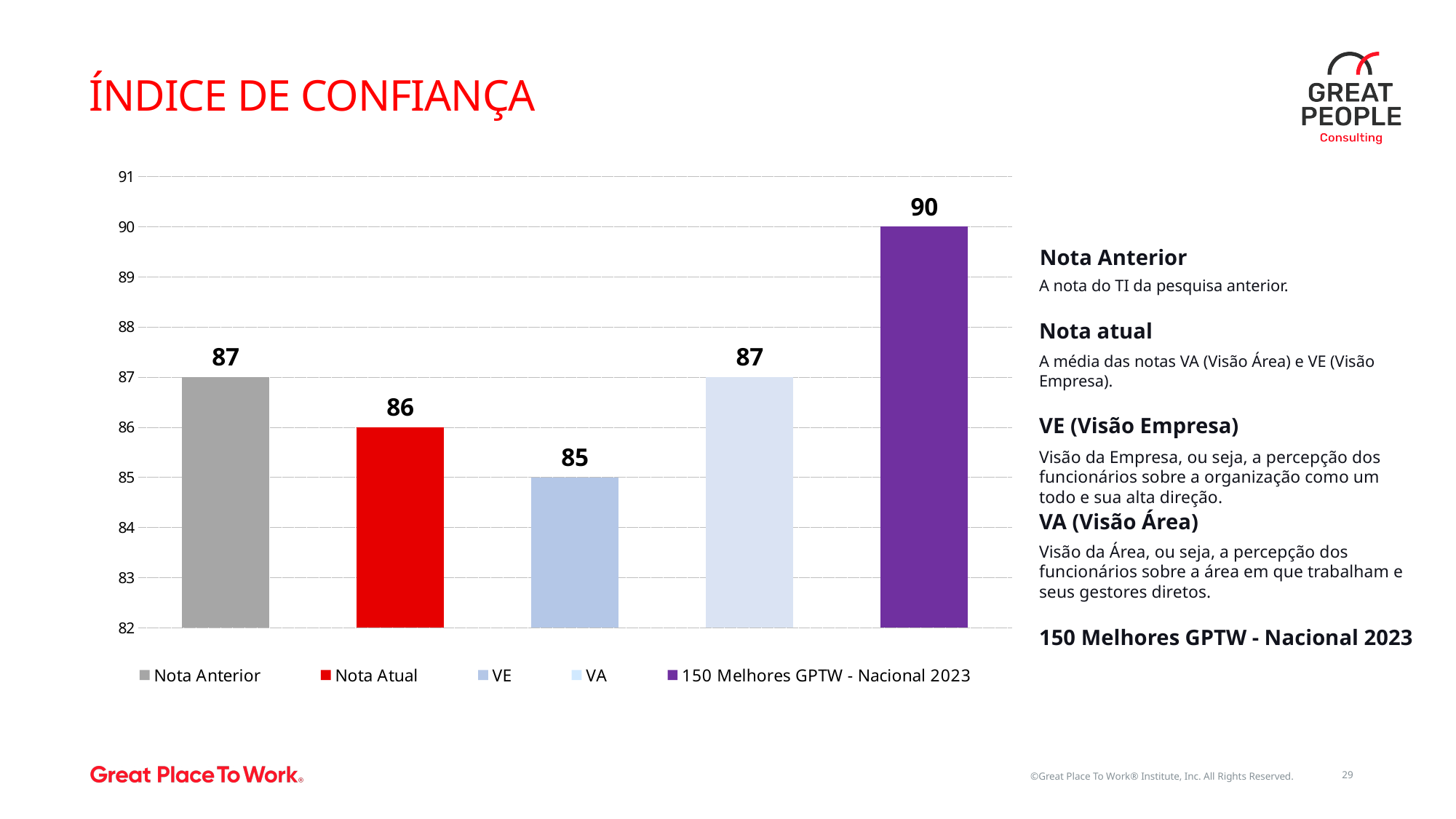
Which series has the lowest value? VE Which series has the highest value? 150 Melhores GPTW - Nacional 2023 Which is larger, Nota Anterior or Nota Atual? Nota Anterior What colour is the Nota Atual bar? Red What is the difference between the 150 Melhores GPTW - Nacional 2023 value and the Nota Atual value? 4 What is the value of the Nota Atual bar? 86 What is the value of the 150 Melhores GPTW - Nacional 2023 bar? 90 What kind of chart is shown on the slide? Bar chart What is the value of the VE bar? 85 What is the difference between the VA value and the VE value? 2 What is the value of the Nota Anterior bar? 87 How many series does the legend list? 5